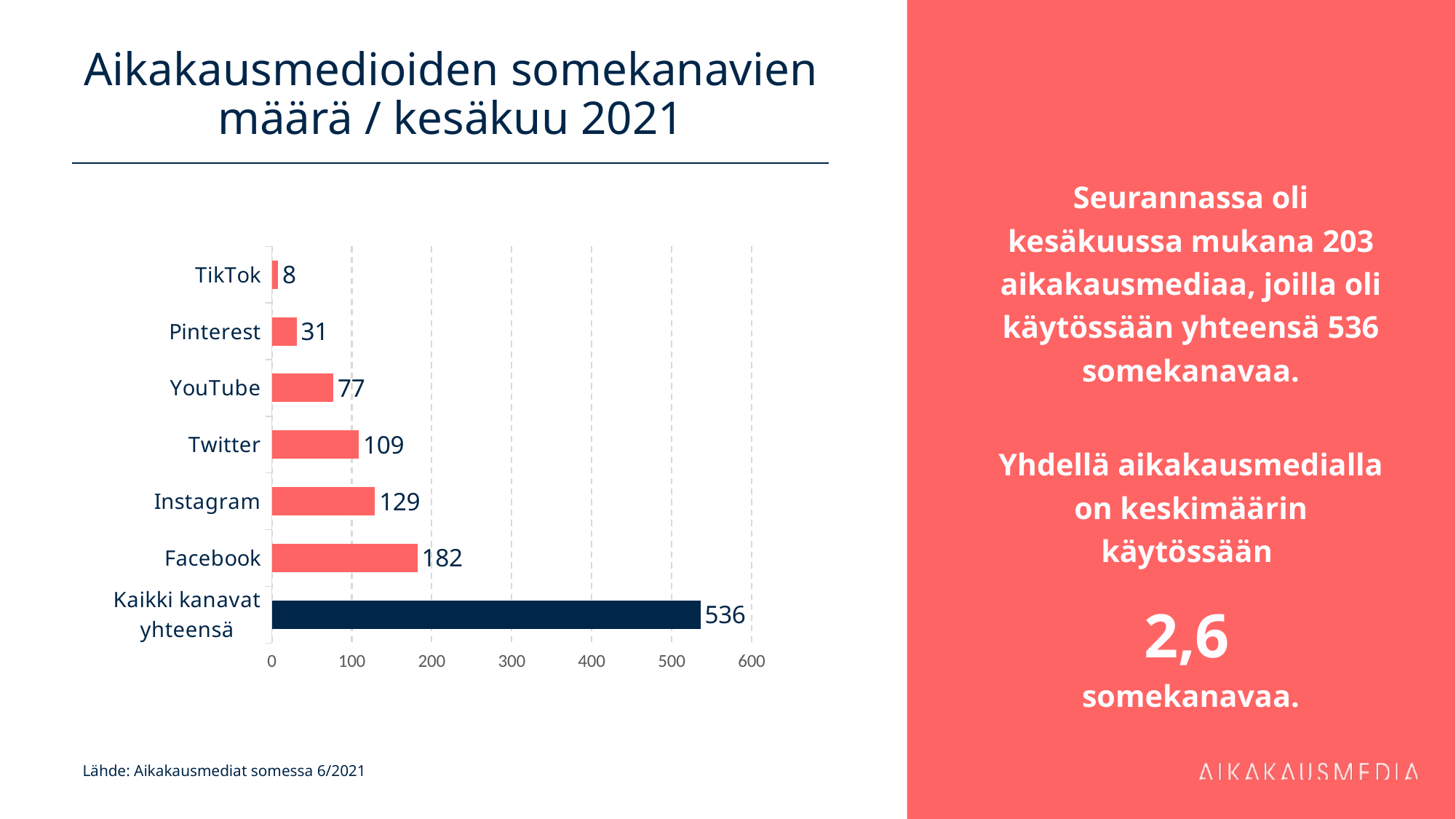
What is the value for Facebook? 182 Among the individual channels (excluding the total bar), which has the highest value? Facebook Is the value for Pinterest greater or less than 100? less Which is larger, the value for Twitter or the value for YouTube? Twitter What is the value for Instagram? 129 What is the value for Kaikki kanavat yhteensä? 536 What is the value for TikTok? 8 What is the title of the chart? Aikakausmedioiden somekanavien määrä / kesäkuu 2021 What kind of chart is shown on the slide? bar chart How many categories are shown in the chart? 7 Which category has the lowest value? TikTok What is the difference between the values for Facebook and Instagram? 53